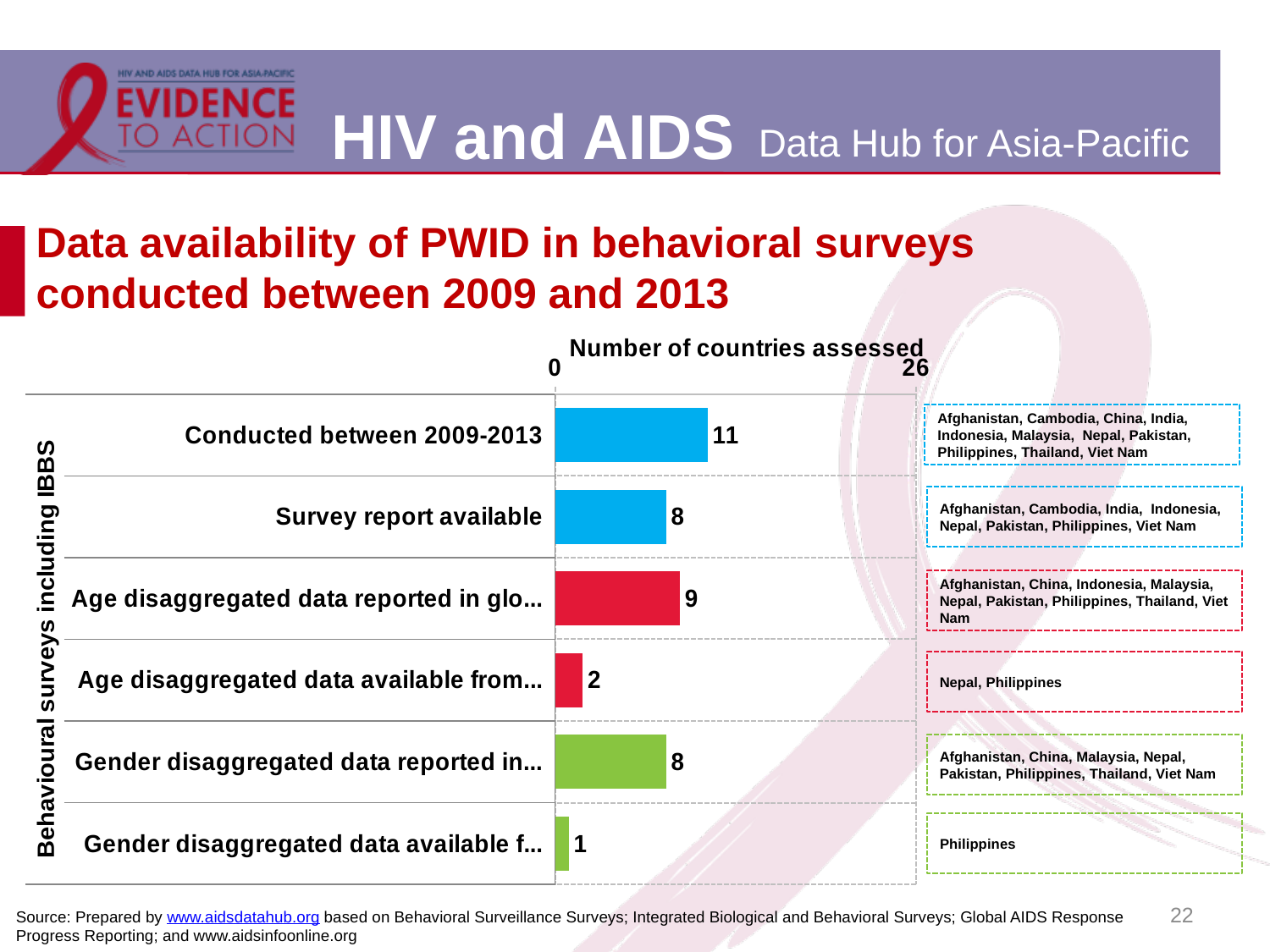
What is the value for "Survey report available"? 8 What is the title of the chart's value axis? Number of countries assessed Which category has the lowest number of countries assessed? Gender disaggregated data available f... What kind of chart is shown on the slide? Bar chart Which is larger: the value for "Age disaggregated data reported in glo..." or the value for "Age disaggregated data available from..."? Age disaggregated data reported in glo... What is the value for the "Age disaggregated data reported in glo..." category? 9 How many categories are shown in the chart? 6 What is the maximum value shown on the chart's value axis? 26 What is the value for "Conducted between 2009-2013"? 11 What is the difference between the value for "Conducted between 2009-2013" and the value for "Survey report available"? 3 What is the value for the "Gender disaggregated data available f..." category? 1 Which category has the highest number of countries assessed? Conducted between 2009-2013